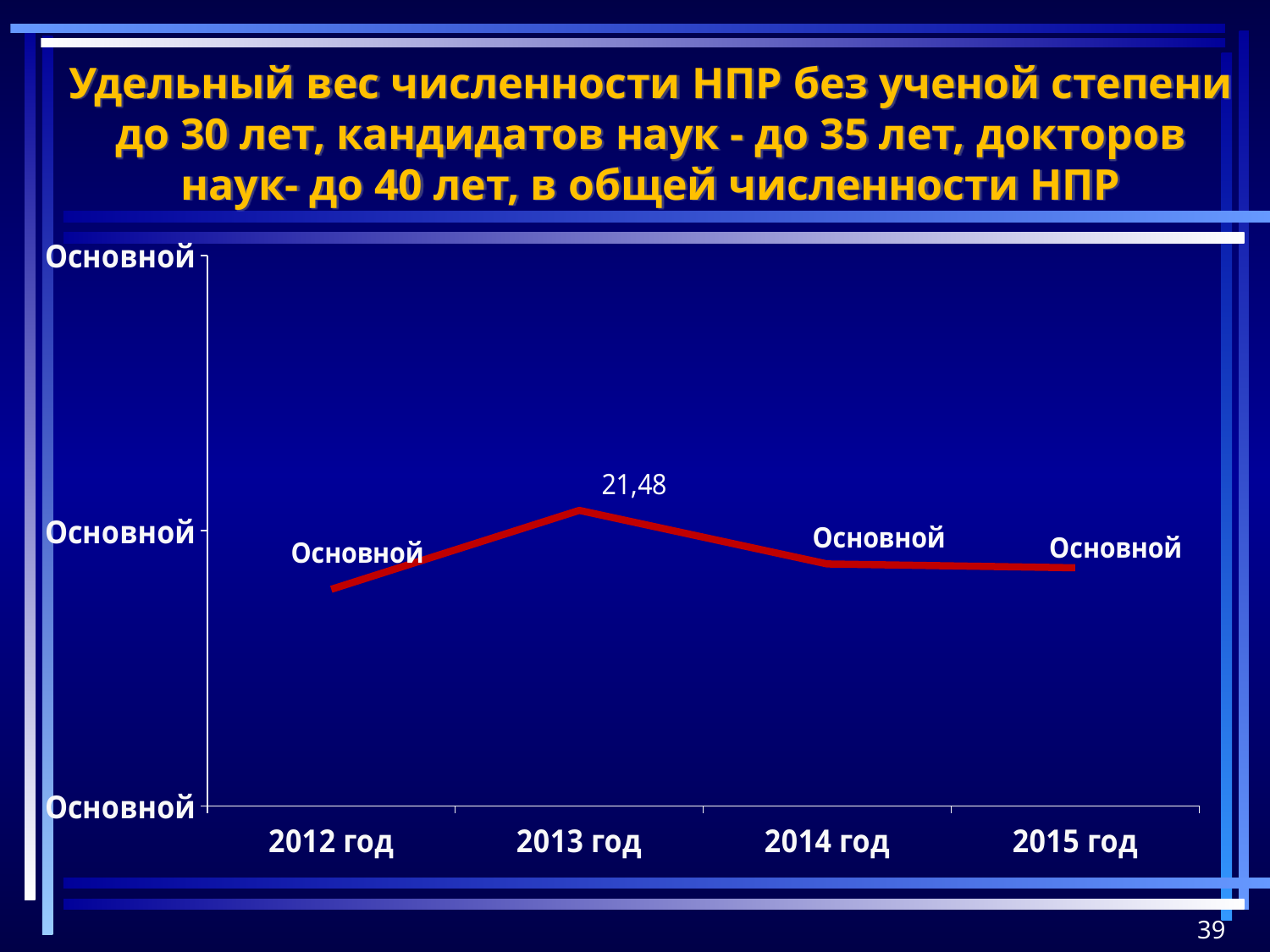
What colour is the plotted line? red Does the line rise or fall from 2012 год to 2013 год? rise Does the line rise or fall from 2013 год to 2015 год? fall How many years are plotted along the x axis? 4 Which is larger, the value for 2012 год or the value for 2013 год? 2013 год Which year is listed first on the x axis? 2012 год Which year has the highest value on the line? 2013 год What kind of chart is shown on the slide? line chart What value is labelled for 2013 год? 21,48 Which is larger, the value for 2012 год or the value for 2014 год? 2014 год Which year has the lowest value on the line? 2012 год